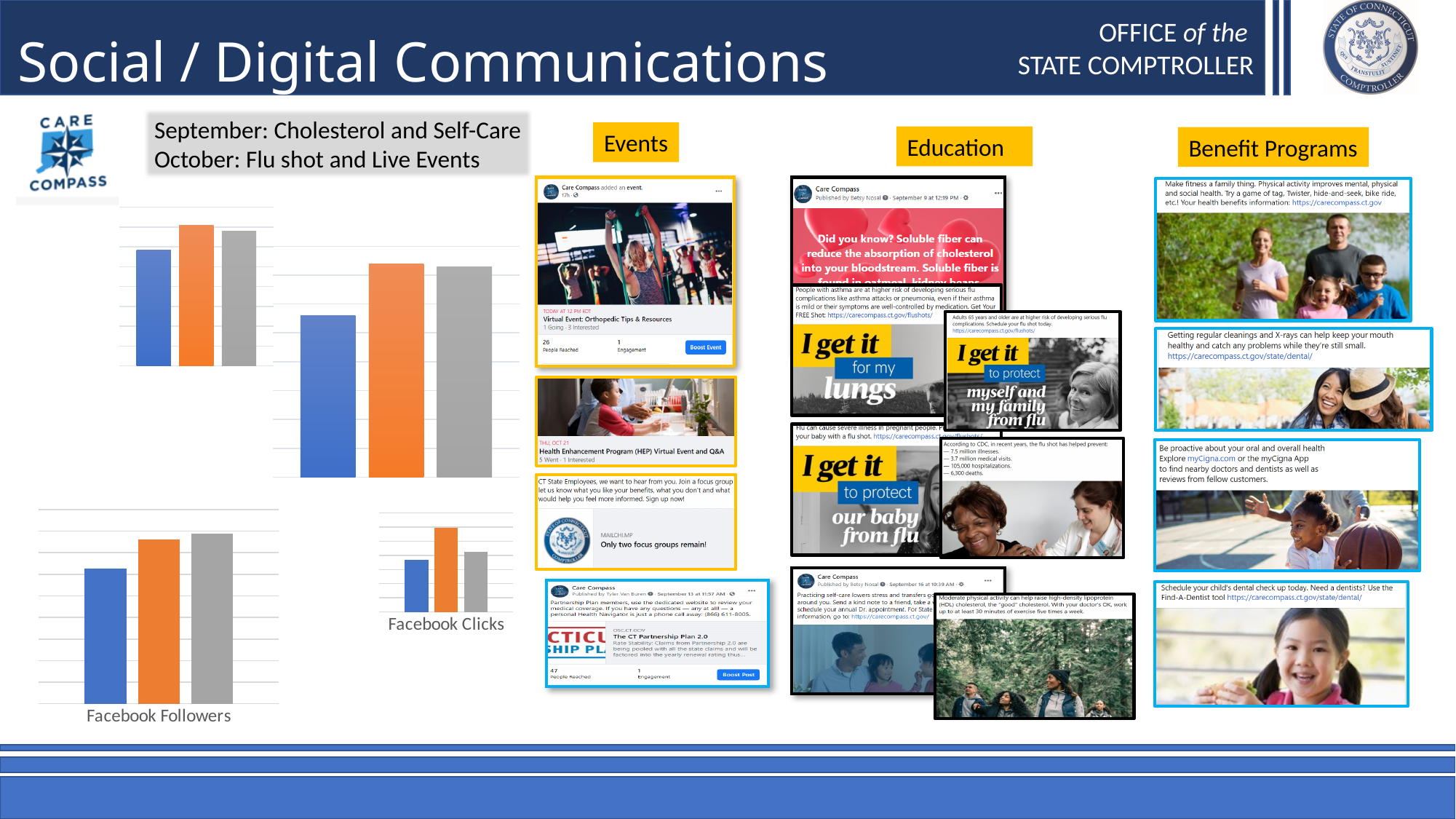
In the 'Facebook Followers' chart, which coloured bar is the tallest? gray What kind of chart is the 'Facebook Followers' chart? bar chart In the 'Facebook Clicks' chart, which coloured bar is the tallest? orange In the 'Facebook Followers' chart, do the bars rise or fall from left to right? rise How many bars are plotted in the 'Facebook Followers' chart? 3 What kind of chart is the 'Facebook Clicks' chart? bar chart How many bars are plotted in the 'Facebook Clicks' chart? 3 In the 'Facebook Clicks' chart, is the orange bar or the gray bar taller? orange In the 'Facebook Followers' chart, is the blue bar or the orange bar taller? orange How many bar charts are shown on the slide? 4 In the 'Facebook Followers' chart, which coloured bar is the shortest? blue In the 'Facebook Clicks' chart, which coloured bar is the shortest? blue